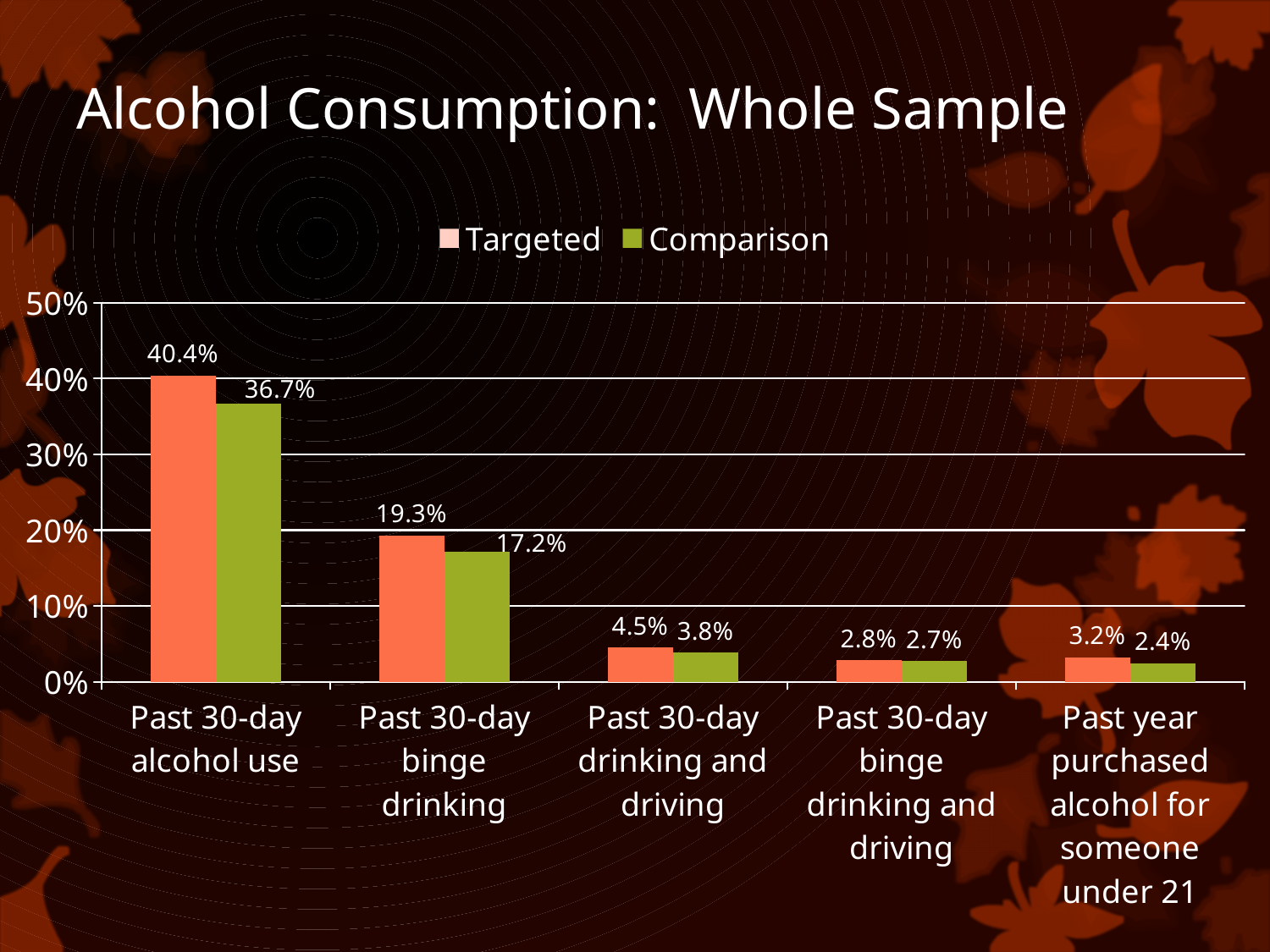
What is the Targeted value for Past 30-day alcohol use? 40.4% Is the Comparison value for Past 30-day alcohol use greater or less than 30%? greater What is the Comparison value for Past 30-day binge drinking? 17.2% Which category has the highest Targeted value? Past 30-day alcohol use Which is larger for Past 30-day binge drinking, the Targeted value or the Comparison value? Targeted Which category has the lowest Comparison value? Past year purchased alcohol for someone under 21 What is the Targeted value for Past year purchased alcohol for someone under 21? 3.2% How many categories are shown on the x axis? 5 What kind of chart is shown on the slide? Bar chart What is the Comparison value for Past 30-day drinking and driving? 3.8% How many series does the legend list? 2 What is the difference between the Targeted and Comparison values for Past 30-day alcohol use? 3.7%